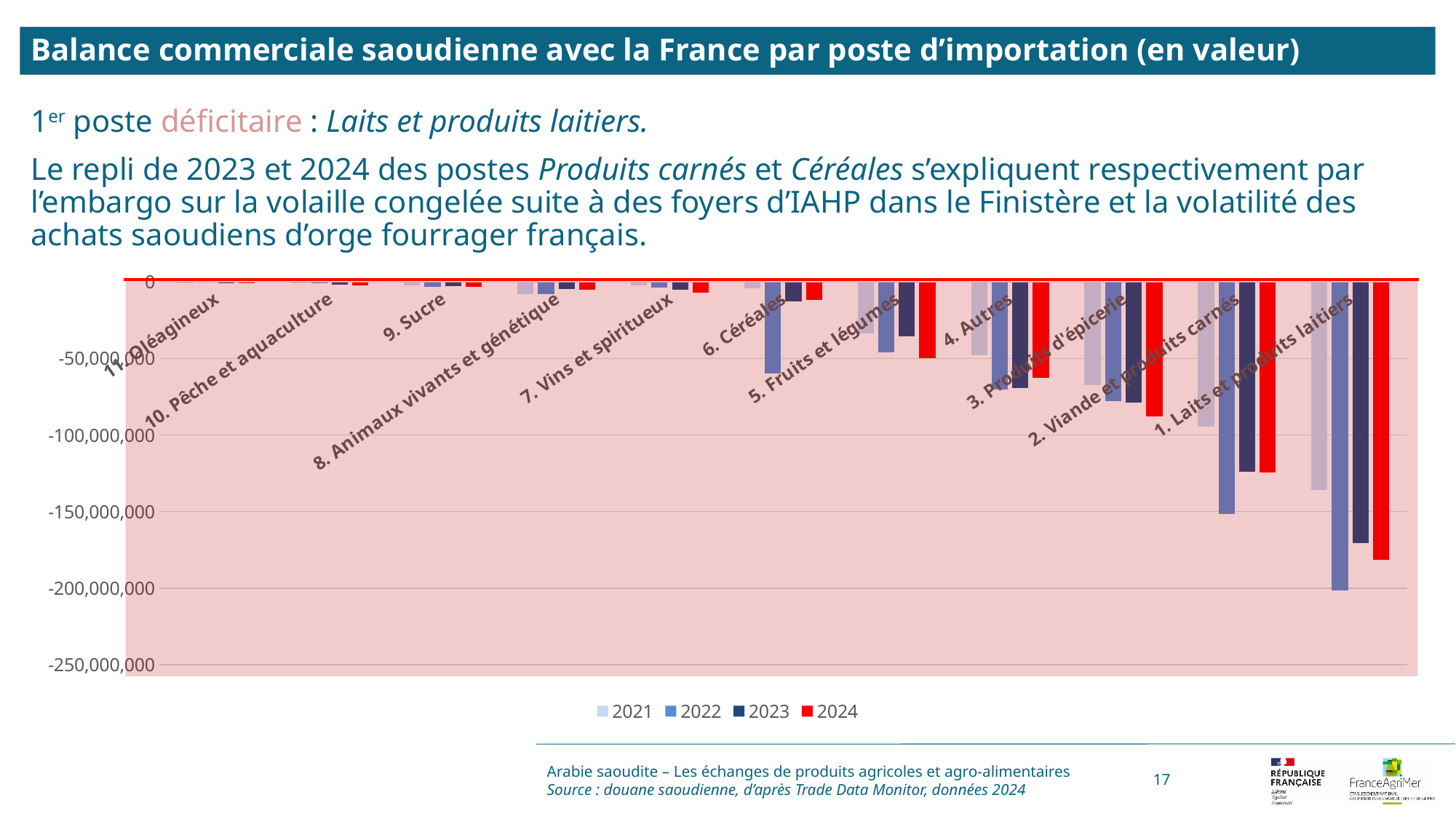
How many import categories are shown on the x axis of the chart? 11 Is the 2022 value for '1. Laits et produits laitiers' greater or less than -150,000,000? less Which years are listed in the chart legend? 2021, 2022, 2023, 2024 Is the 2024 value for '6. Céréales' greater or less than -50,000,000? greater Which category has the lowest (most negative) value for 2024? 1. Laits et produits laitiers What kind of chart is shown on the slide? bar chart Is the 2023 value for '2. Viande et produits carnés' greater or less than -150,000,000? greater Which is more negative for 2022: '1. Laits et produits laitiers' or '2. Viande et produits carnés'? 1. Laits et produits laitiers Moving from left to right along the x axis, do the 2024 values generally become more negative or less negative? more negative Which category has the lowest (most negative) value for 2022? 1. Laits et produits laitiers How many series does the chart legend list? 4